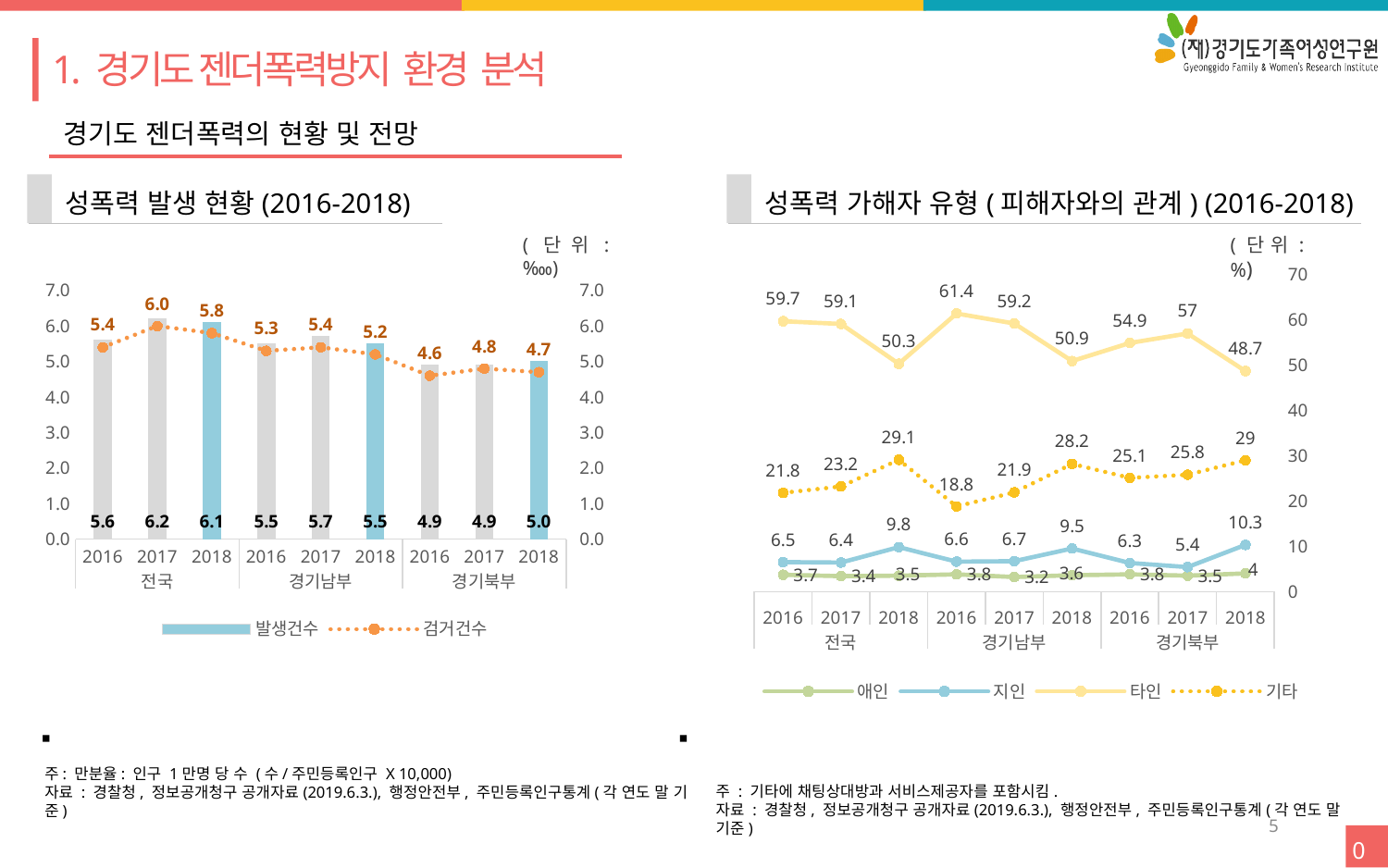
In the right chart '성폭력 가해자 유형 (피해자와의 관계) (2016-2018)', is the 기타 value for 전국 in 2018 larger or smaller than the 기타 value for 경기남부 in 2016? larger What kind of chart is the right chart '성폭력 가해자 유형 (피해자와의 관계) (2016-2018)'? line chart In the left chart '성폭력 발생 현황 (2016-2018)', how many series does the legend list? 2 In the right chart '성폭력 가해자 유형 (피해자와의 관계) (2016-2018)', what is the 지인 value for 경기북부 in 2018? 10.3 In the left chart '성폭력 발생 현황 (2016-2018)', which category has the highest 발생건수 value? 전국 2017 In the left chart '성폭력 발생 현황 (2016-2018)', what is the difference between the 발생건수 and 검거건수 values for 경기남부 in 2018? 0.3 In the right chart '성폭력 가해자 유형 (피해자와의 관계) (2016-2018)', how many series does the legend list? 4 In the left chart '성폭력 발생 현황 (2016-2018)', what is the 검거건수 value for 경기북부 in 2016? 4.6 In the left chart '성폭력 발생 현황 (2016-2018)', how many bars are plotted? 9 In the right chart '성폭력 가해자 유형 (피해자와의 관계) (2016-2018)', what is the 타인 value for 경기남부 in 2016? 61.4 In the right chart '성폭력 가해자 유형 (피해자와의 관계) (2016-2018)', which series has the lowest values across all categories? 애인 In the left chart '성폭력 발생 현황 (2016-2018)', what is the 발생건수 value for 전국 in 2017? 6.2